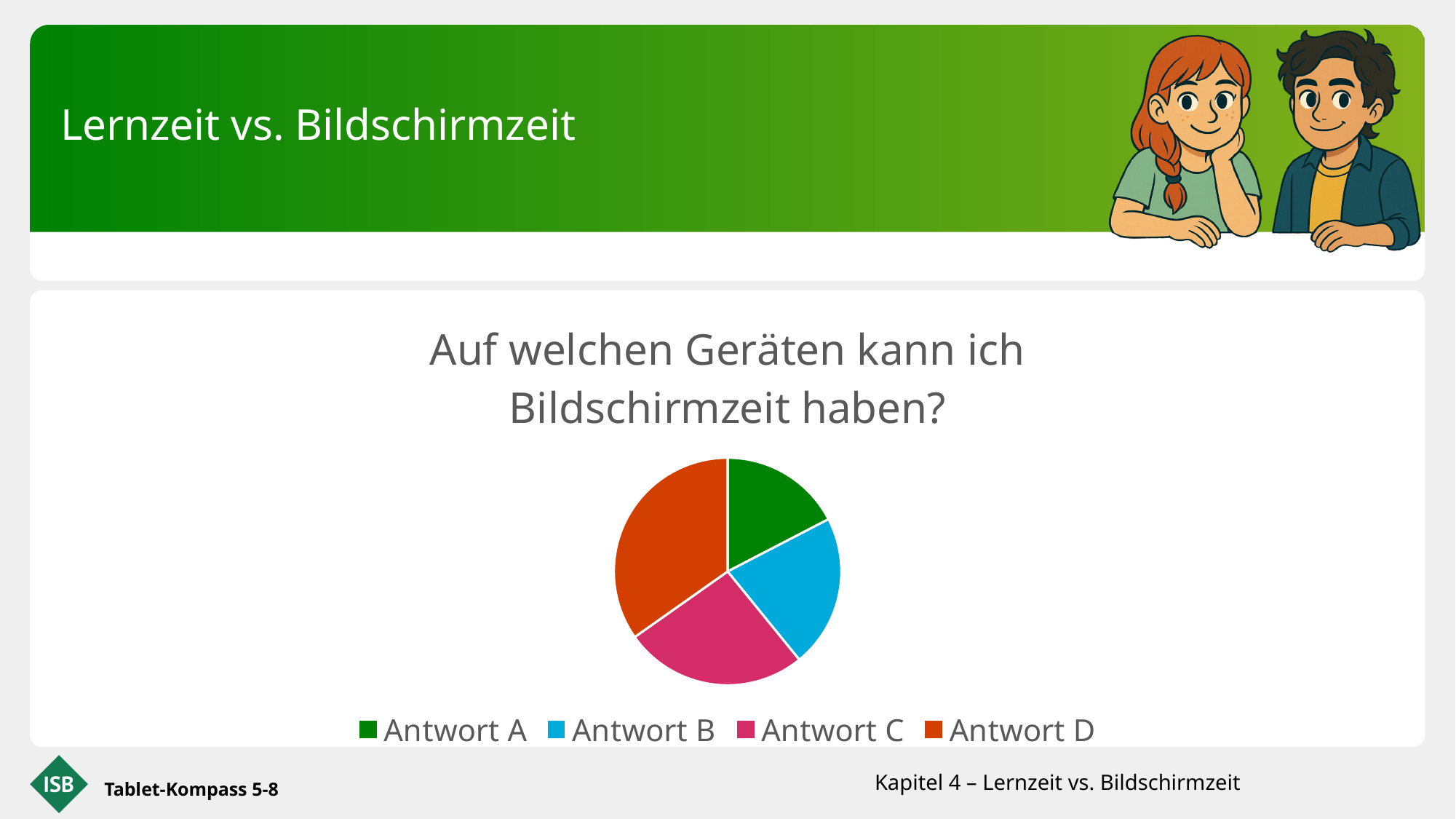
Which colour represents Antwort C in the pie chart? pink Which answer has the largest slice in the pie chart? Antwort D What kind of chart is shown on the slide? pie chart Which slice is larger in the pie chart, Antwort D or Antwort A? Antwort D How many slices does the pie chart have? 4 Which slice is larger in the pie chart, Antwort C or Antwort A? Antwort C Which answer has the smallest slice in the pie chart? Antwort A How many entries does the legend of the pie chart list? 4 What is the title of the pie chart? Auf welchen Geräten kann ich Bildschirmzeit haben? Which slice is larger in the pie chart, Antwort B or Antwort D? Antwort D